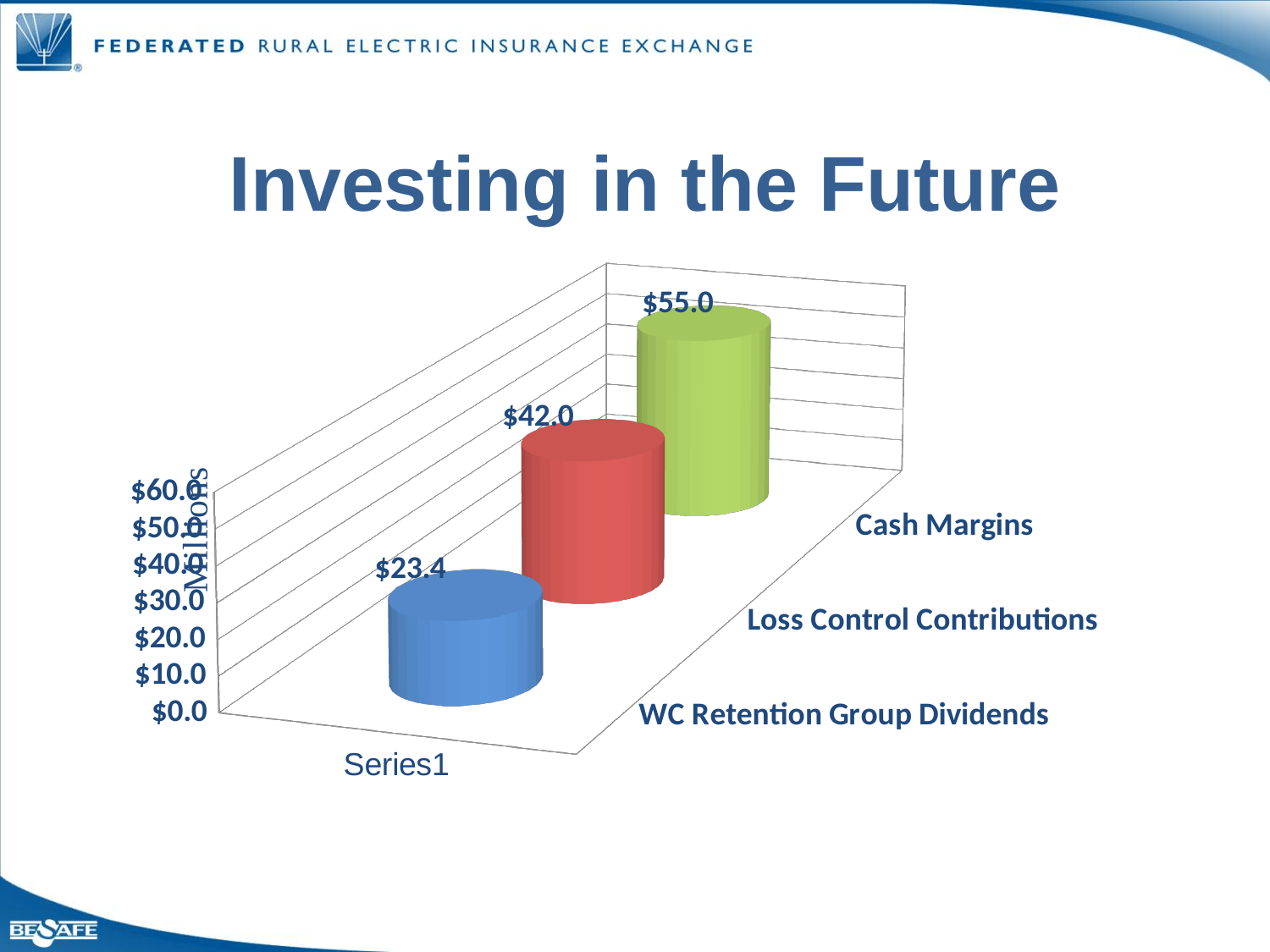
Which category has the lowest value? WC Retention Group Dividends How many categories are plotted in the chart? 3 Which category has the highest value? Cash Margins Is the value for Cash Margins greater or less than $50.0? greater Which is larger, the value for Loss Control Contributions or the value for WC Retention Group Dividends? Loss Control Contributions What is the value for Loss Control Contributions? $42.0 What kind of chart is shown on the slide? bar chart What is the value for WC Retention Group Dividends? $23.4 What is the value for Cash Margins? $55.0 What is the label on the vertical axis of the chart? Millions What is the difference between the values for Cash Margins and Loss Control Contributions? $13.0 What is the difference between the values for Loss Control Contributions and WC Retention Group Dividends? $18.6